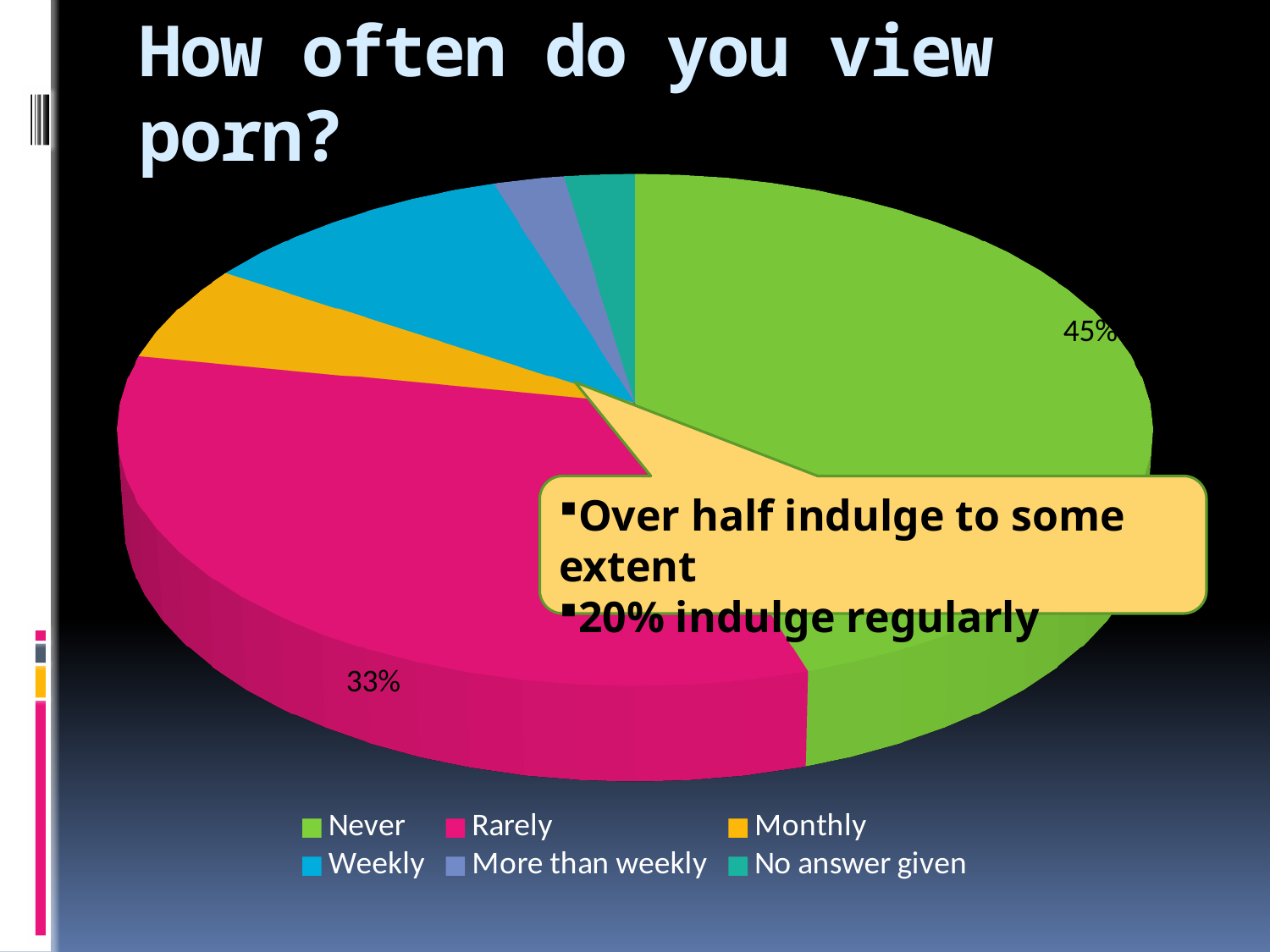
Which is larger, the slice for "Monthly" or the slice for "Rarely"? Rarely What colour represents "Never" in the chart? Green What is the combined share of "Never" and "Rarely"? 78% What percentage of respondents answered "Rarely"? 33% What is the difference in percentage points between the "Never" and "Rarely" shares? 12 Which category has the largest share of the pie? Never What is the title of the slide? How often do you view porn? Which is larger, the share for "Never" or the share for "Rarely"? Never What percentage of respondents answered "Never"? 45% What kind of chart is shown on the slide? Pie chart Which is larger, the slice for "Weekly" or the slice for "Monthly"? Weekly How many categories does the legend list? 6